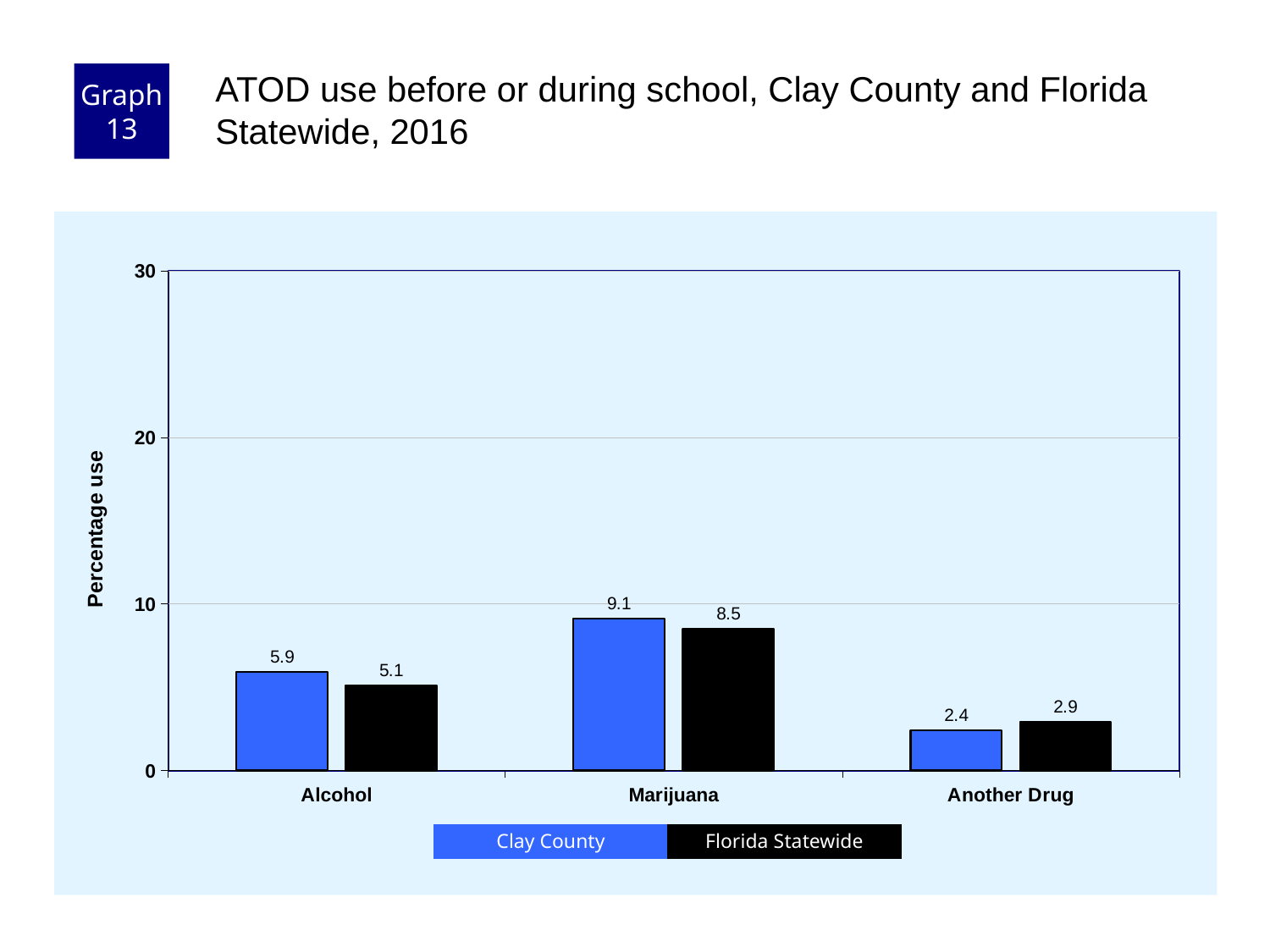
What is the Clay County value for Another Drug? 2.4 Which is larger for Another Drug, Clay County or Florida Statewide? Florida Statewide What kind of chart is shown on the slide? bar chart What is the Florida Statewide value for Marijuana? 8.5 What is the Clay County value for Alcohol? 5.9 Which category has the lowest Florida Statewide value? Another Drug Which category has the highest Clay County value? Marijuana What is the difference between the Clay County and Florida Statewide values for Alcohol? 0.8 How many series does the legend list? 2 What is the label of the y axis? Percentage use How many categories are shown on the x axis? 3 Is the Clay County value for Marijuana greater or less than 10? less